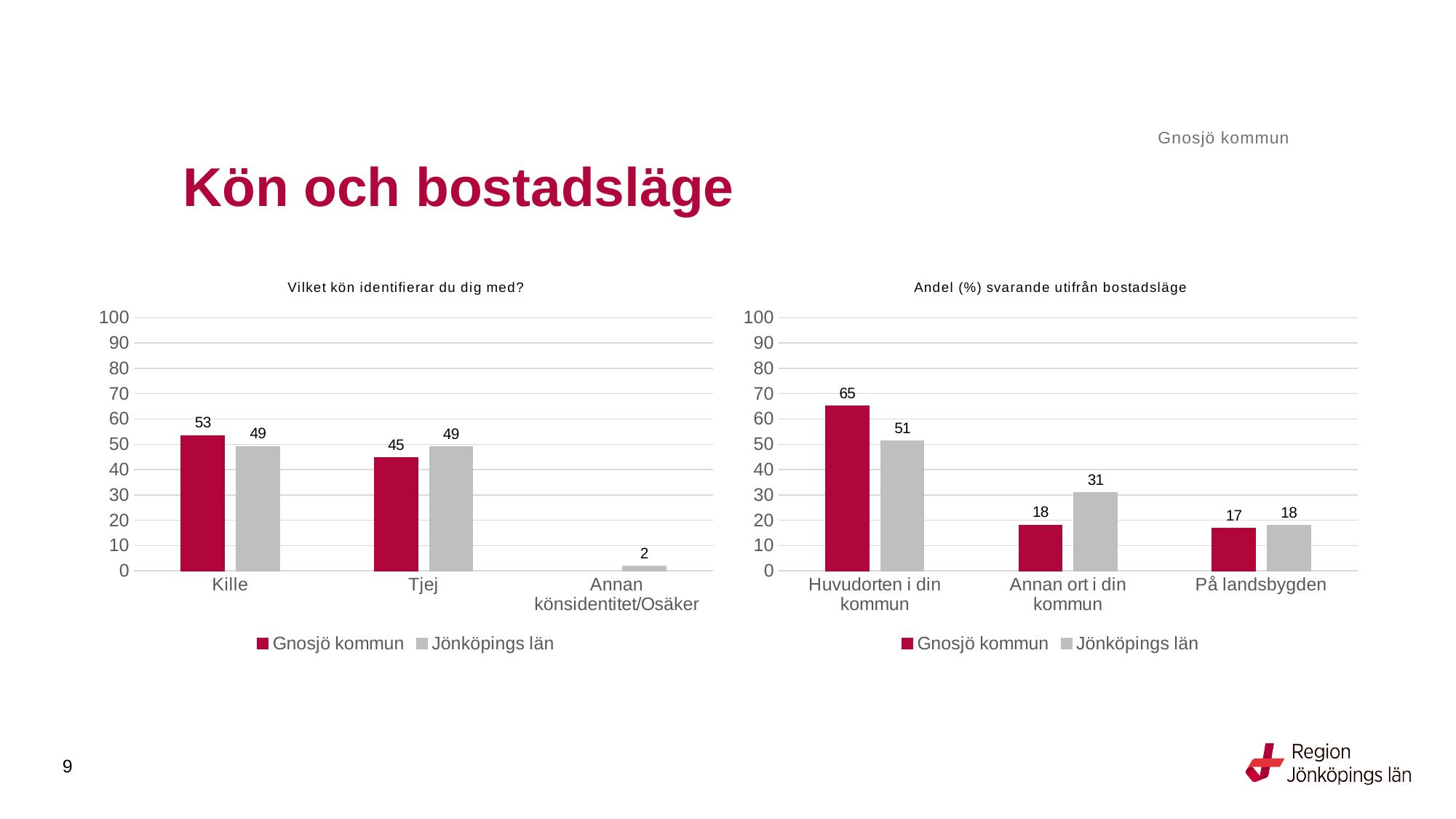
In the chart titled 'Vilket kön identifierar du dig med?', how many categories are shown on the x axis? 3 In the chart titled 'Andel (%) svarande utifrån bostadsläge', which is larger for Annan ort i din kommun: Gnosjö kommun or Jönköpings län? Jönköpings län In the chart titled 'Vilket kön identifierar du dig med?', what is the value for Gnosjö kommun for Kille? 53 In the chart titled 'Vilket kön identifierar du dig med?', what is the value for Jönköpings län for Annan könsidentitet/Osäker? 2 How many series does the legend of the chart titled 'Andel (%) svarande utifrån bostadsläge' list? 2 In the chart titled 'Andel (%) svarande utifrån bostadsläge', what is the value for Gnosjö kommun for Huvudorten i din kommun? 65 In the chart titled 'Vilket kön identifierar du dig med?', what is the value for Jönköpings län for Tjej? 49 In the chart titled 'Andel (%) svarande utifrån bostadsläge', what is the value for Jönköpings län for Annan ort i din kommun? 31 In the chart titled 'Andel (%) svarande utifrån bostadsläge', which category has the lowest value for Gnosjö kommun? På landsbygden In the chart titled 'Andel (%) svarande utifrån bostadsläge', which category has the highest value for Gnosjö kommun? Huvudorten i din kommun In the chart titled 'Andel (%) svarande utifrån bostadsläge', what is the difference between Gnosjö kommun and Jönköpings län for Huvudorten i din kommun? 14 In the chart titled 'Vilket kön identifierar du dig med?', what is the difference between the Gnosjö kommun values for Kille and Tjej? 8